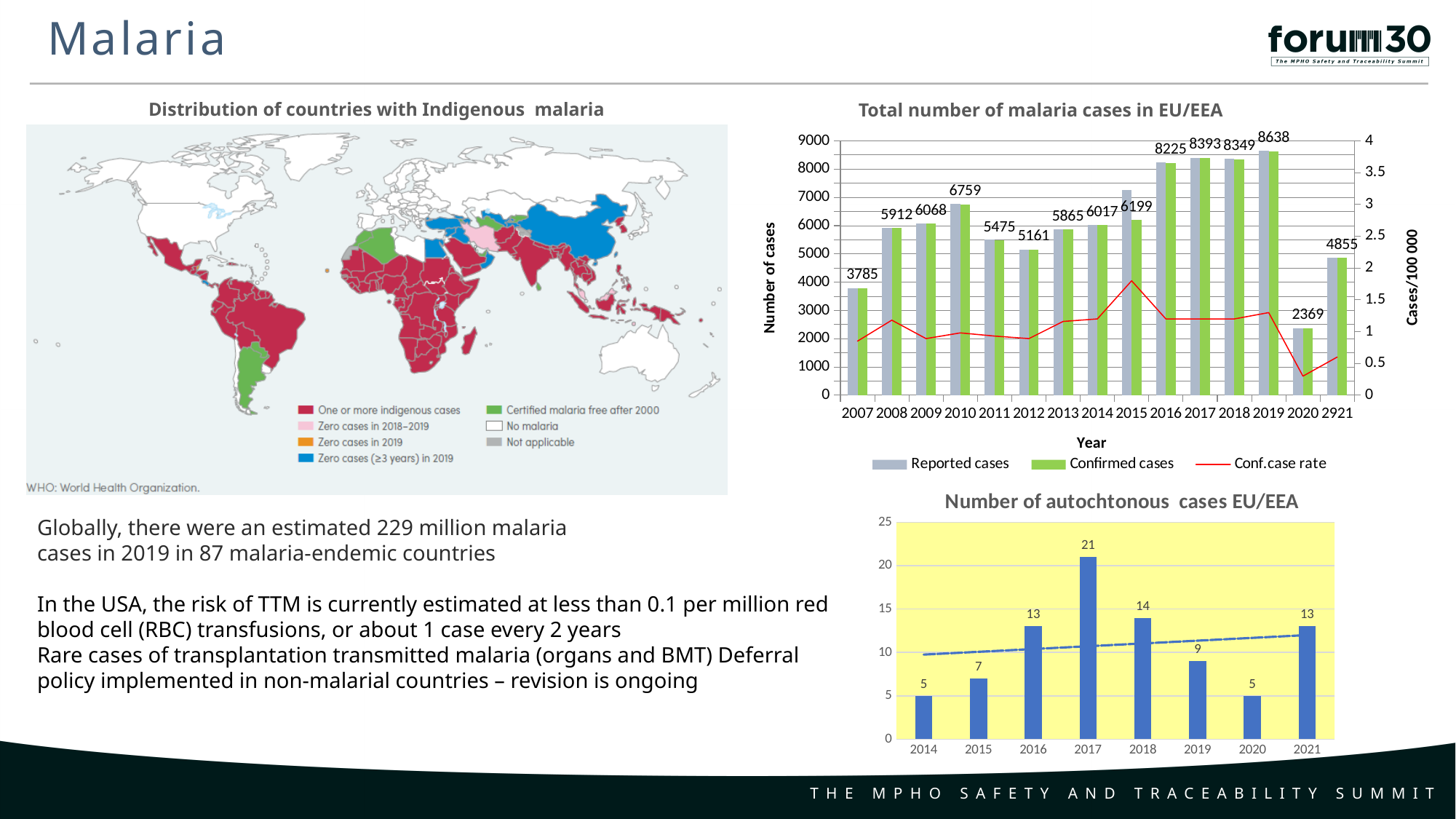
In the 'Total number of malaria cases in EU/EEA' chart, is the labelled number of confirmed cases for 2016 greater or less than the value for 2015? 2016 is greater In the 'Total number of malaria cases in EU/EEA' chart, which year has the lowest labelled number of confirmed cases? 2020 In the 'Number of autochtonous cases EU/EEA' chart, how many years are shown on the x axis? 8 What kind of chart is 'Number of autochtonous cases EU/EEA'? Bar chart In the 'Number of autochtonous cases EU/EEA' chart, what is the value for 2019? 9 In the 'Number of autochtonous cases EU/EEA' chart, what is the difference between the values for 2017 and 2018? 7 In the 'Total number of malaria cases in EU/EEA' chart, what is the label of the right-hand vertical axis? Cases/100 000 In the 'Total number of malaria cases in EU/EEA' chart, how many series does the legend list? 3 In the 'Number of autochtonous cases EU/EEA' chart, what is the value for 2017? 21 In the 'Number of autochtonous cases EU/EEA' chart, which year has the highest number of cases? 2017 In the 'Total number of malaria cases in EU/EEA' chart, what is the labelled number of confirmed cases for 2007? 3785 In the 'Total number of malaria cases in EU/EEA' chart, what is the labelled number of confirmed cases for 2019? 8638